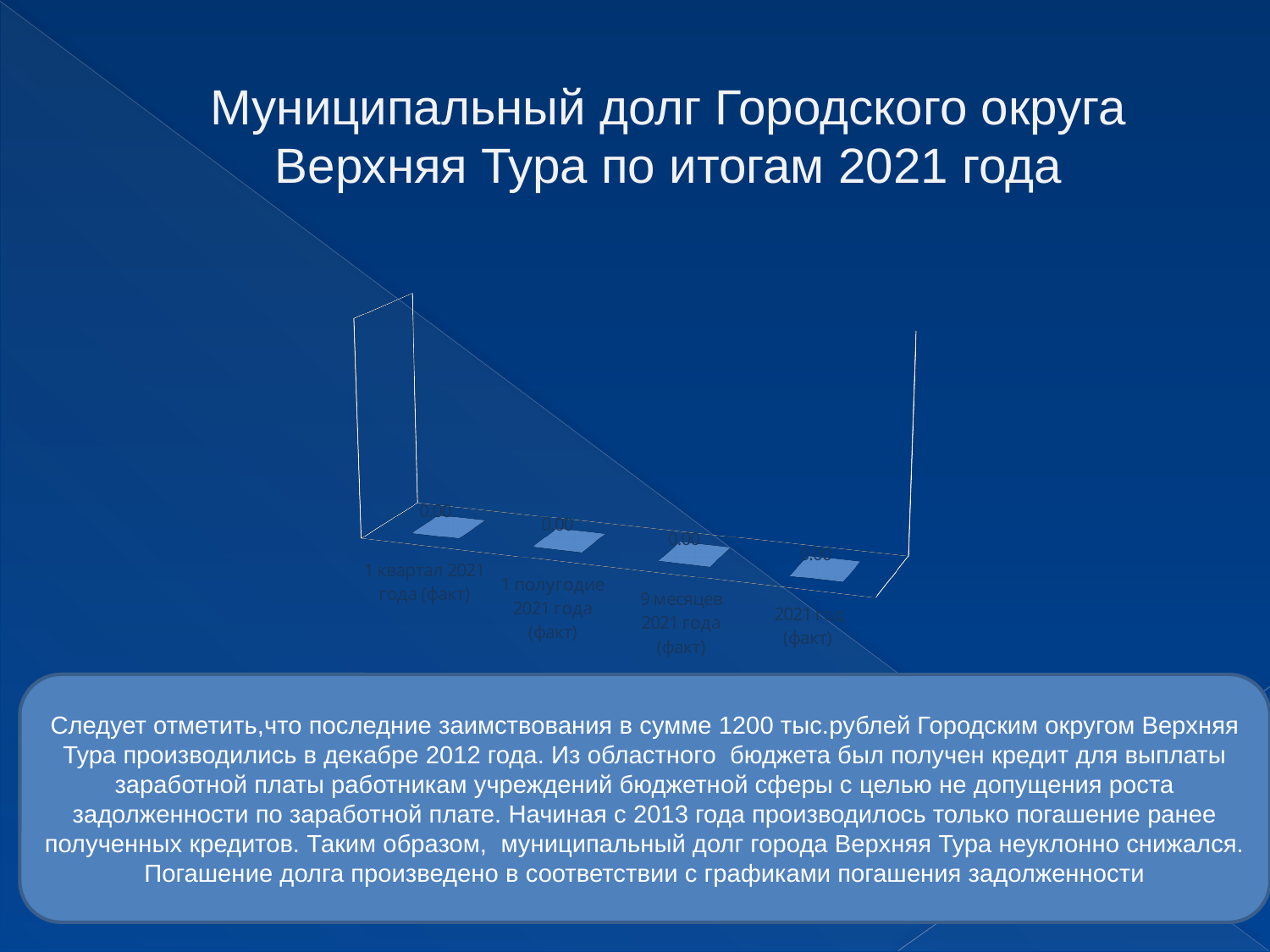
How many categories are plotted on the chart? 4 What is the value shown for "1 квартал 2021 года (факт)"? 0,00 What kind of chart is shown on the slide? Bar chart Do the values rise, fall or stay flat across the categories from left to right? Stay flat What is the value shown for "1 полугодие 2021 года (факт)"? 0,00 What is the first category label on the left of the chart? 1 квартал 2021 года (факт) What is the value shown for "9 месяцев 2021 года (факт)"? 0,00 What is the difference between the values for "1 квартал 2021 года (факт)" and "2021 год (факт)"? 0,00 What is the value shown for "2021 год (факт)"? 0,00 What is the last category label on the right of the chart? 2021 год (факт)